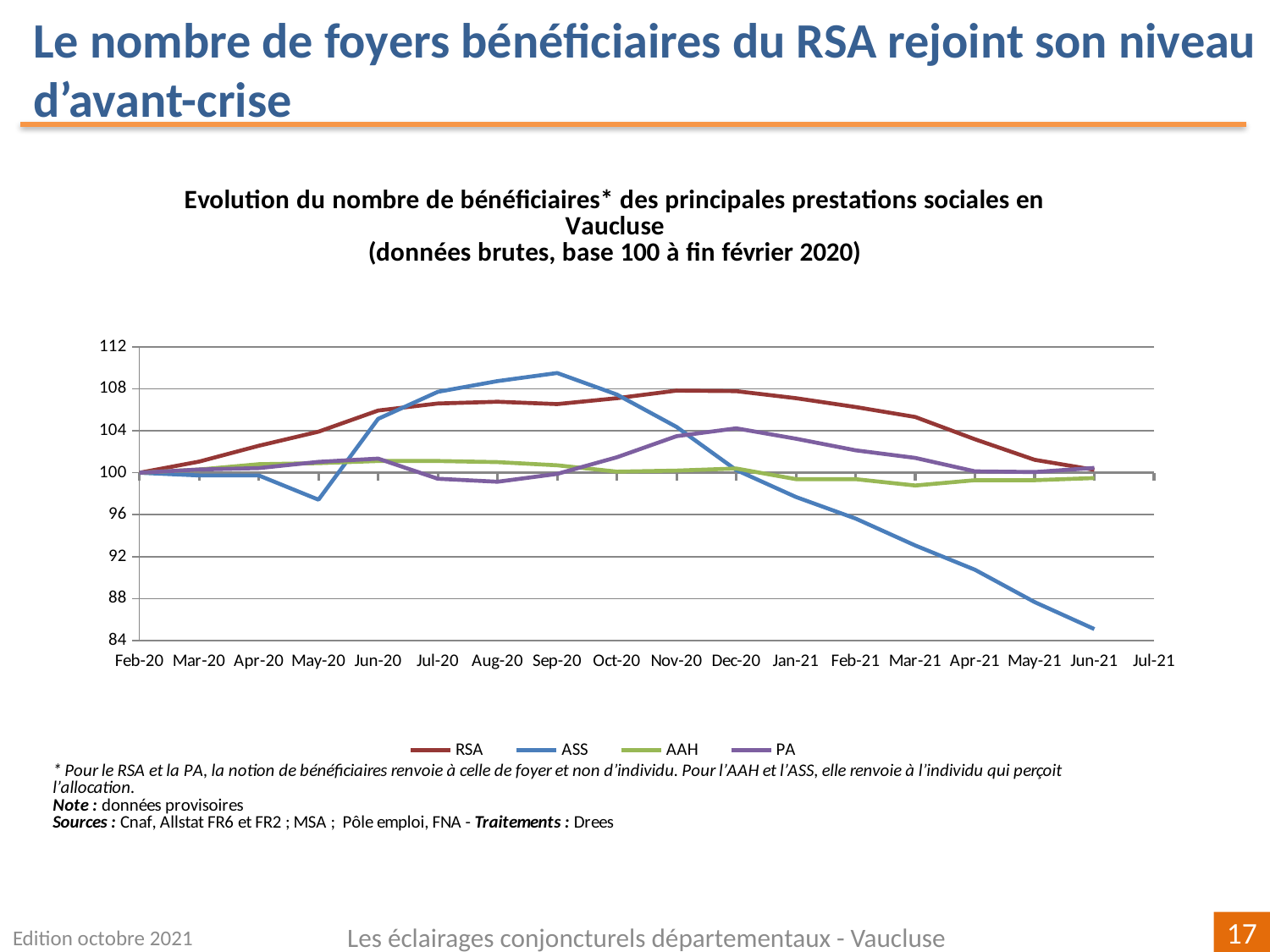
Is the value for ASS in May-20 greater or less than 100? less How many series does the legend list? 4 Does the ASS series rise or fall between Sep-20 and Jun-21? fall Which series has the highest value in Sep-20? ASS Which series does the legend list first? RSA Is the value for ASS in Sep-20 greater or less than 108? greater In Jan-21, which is larger, the value for RSA or the value for ASS? RSA What is the base period stated in the chart title (base 100)? fin février 2020 Is the value for RSA in Nov-20 greater or less than 104? greater What kind of chart is shown on the slide? line chart Which series has the lowest value in Jun-21? ASS